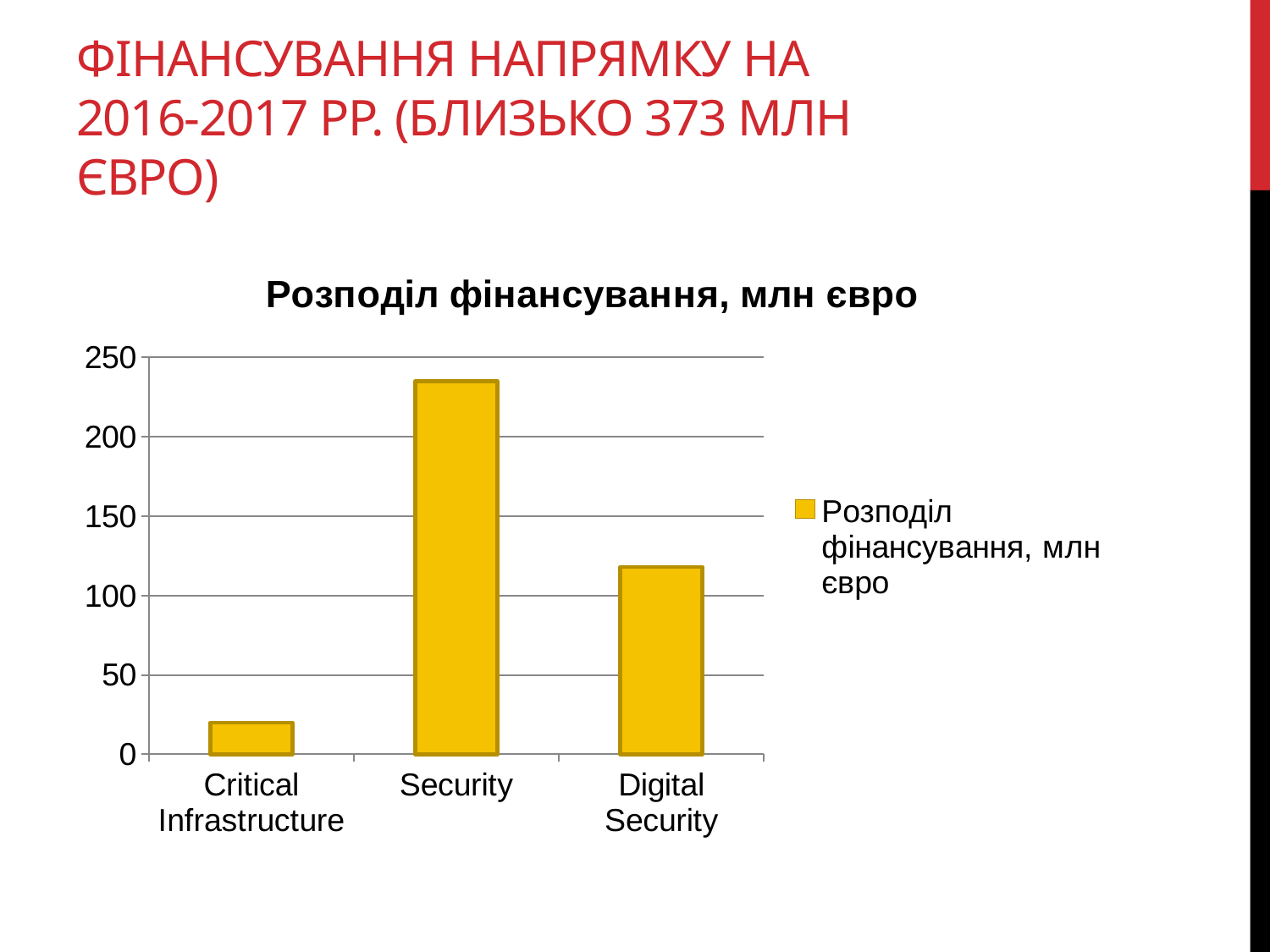
Which is larger, the value for Security or the value for Digital Security? Security Is the value for Security greater or less than 200? greater What kind of chart is shown on the slide? bar chart Is the value for Digital Security greater or less than 100? greater What colour are the bars in the chart? yellow Which is larger, the value for Critical Infrastructure or the value for Digital Security? Digital Security Which category has the lowest value in the chart? Critical Infrastructure Is the value for Critical Infrastructure greater or less than 50? less Which category has the highest value in the chart? Security How many categories are shown on the x axis of the chart? 3 What is the title of the chart? Розподіл фінансування, млн євро How many series does the chart legend list? 1